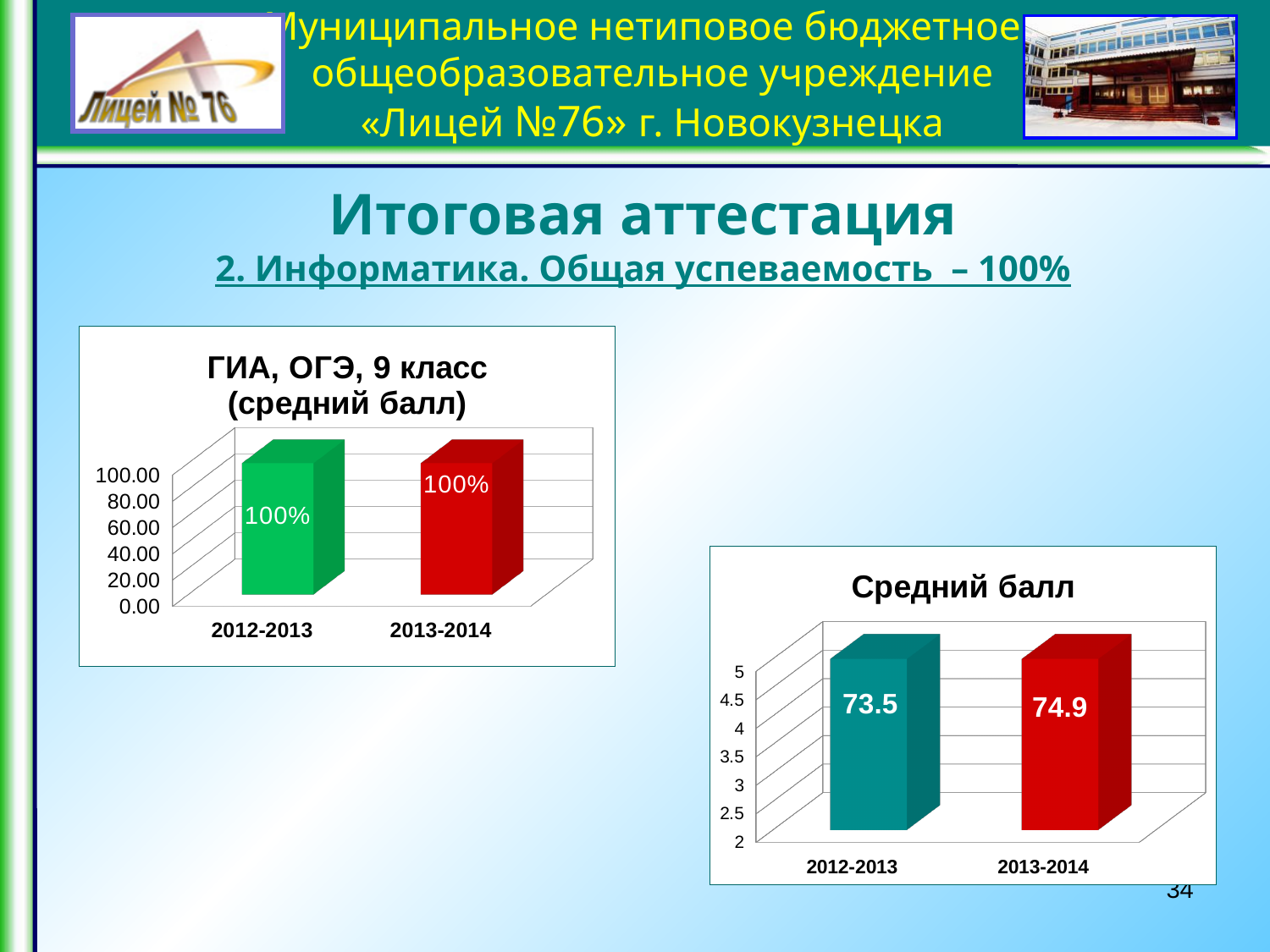
In the chart titled "Средний балл", do the values rise or fall from 2012-2013 to 2013-2014? Rise In the chart titled "ГИА, ОГЭ, 9 класс (средний балл)", what is the value for 2012-2013? 100% In the chart titled "ГИА, ОГЭ, 9 класс (средний балл)", how many categories are shown on the x axis? 2 In the chart titled "Средний балл", how many bars are shown? 2 In the chart titled "Средний балл", what is the value for 2013-2014? 74.9 In the chart titled "Средний балл", what is the value for 2012-2013? 73.5 In the chart titled "Средний балл", which year has the lower value? 2012-2013 In the chart titled "Средний балл", what is the difference between the values for 2013-2014 and 2012-2013? 1.4 In the chart titled "Средний балл", which year has the higher value? 2013-2014 In the chart titled "ГИА, ОГЭ, 9 класс (средний балл)", what is the value for 2013-2014? 100% What is the title of the chart in the lower right of the slide? Средний балл What kind of chart is the chart titled "ГИА, ОГЭ, 9 класс (средний балл)"? Bar chart